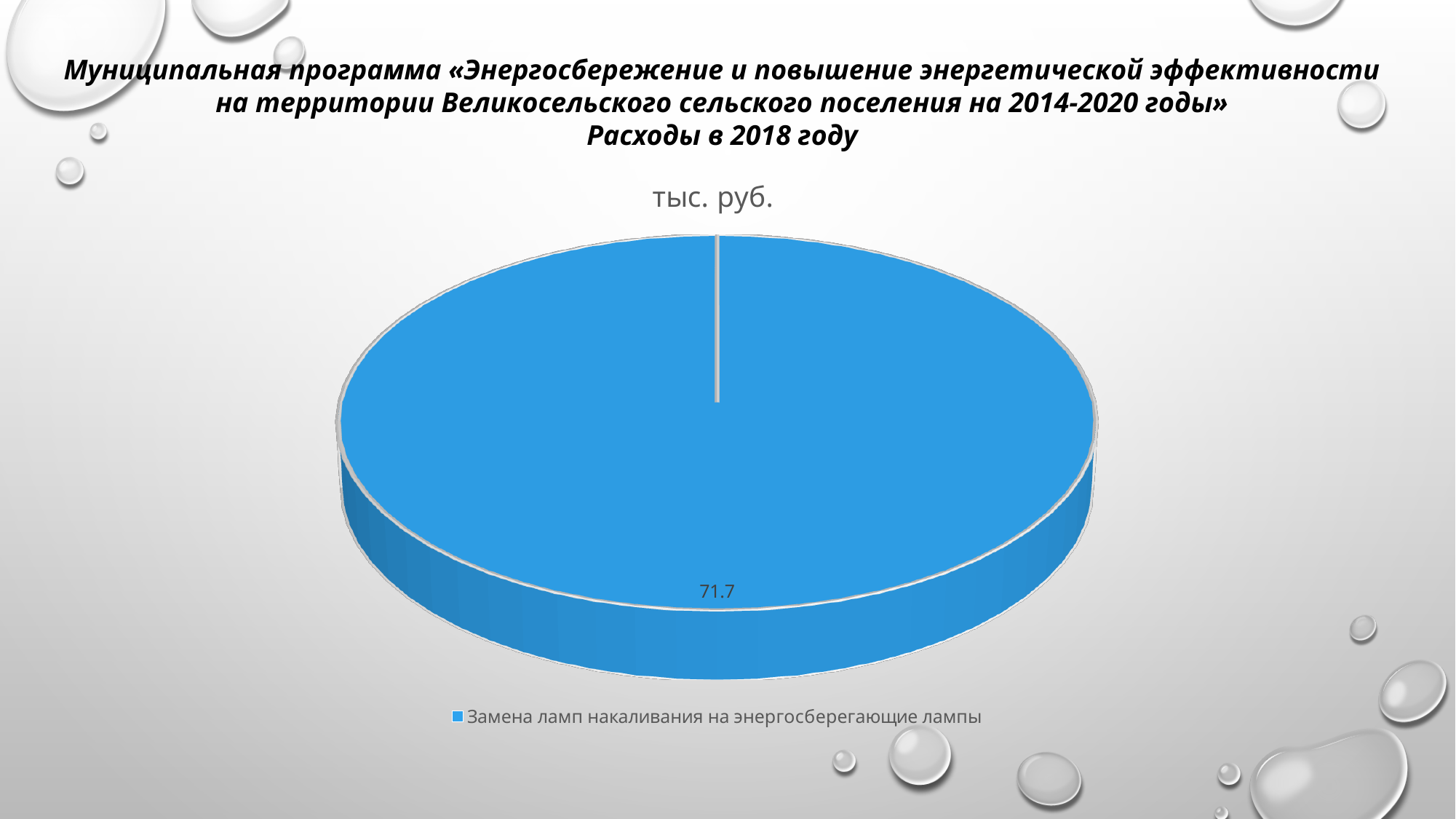
What kind of chart is shown on the slide? pie chart How many entries does the legend list? 1 What is the value shown for "Замена ламп накаливания на энергосберегающие лампы"? 71.7 What share of the pie does "Замена ламп накаливания на энергосберегающие лампы" take? 100% Is the value for "Замена ламп накаливания на энергосберегающие лампы" greater or less than 50? greater What is the legend entry of the chart? Замена ламп накаливания на энергосберегающие лампы What is the total of all slices in the pie chart? 71.7 How many slices does the pie chart have? 1 What is the title of the chart? тыс. руб.